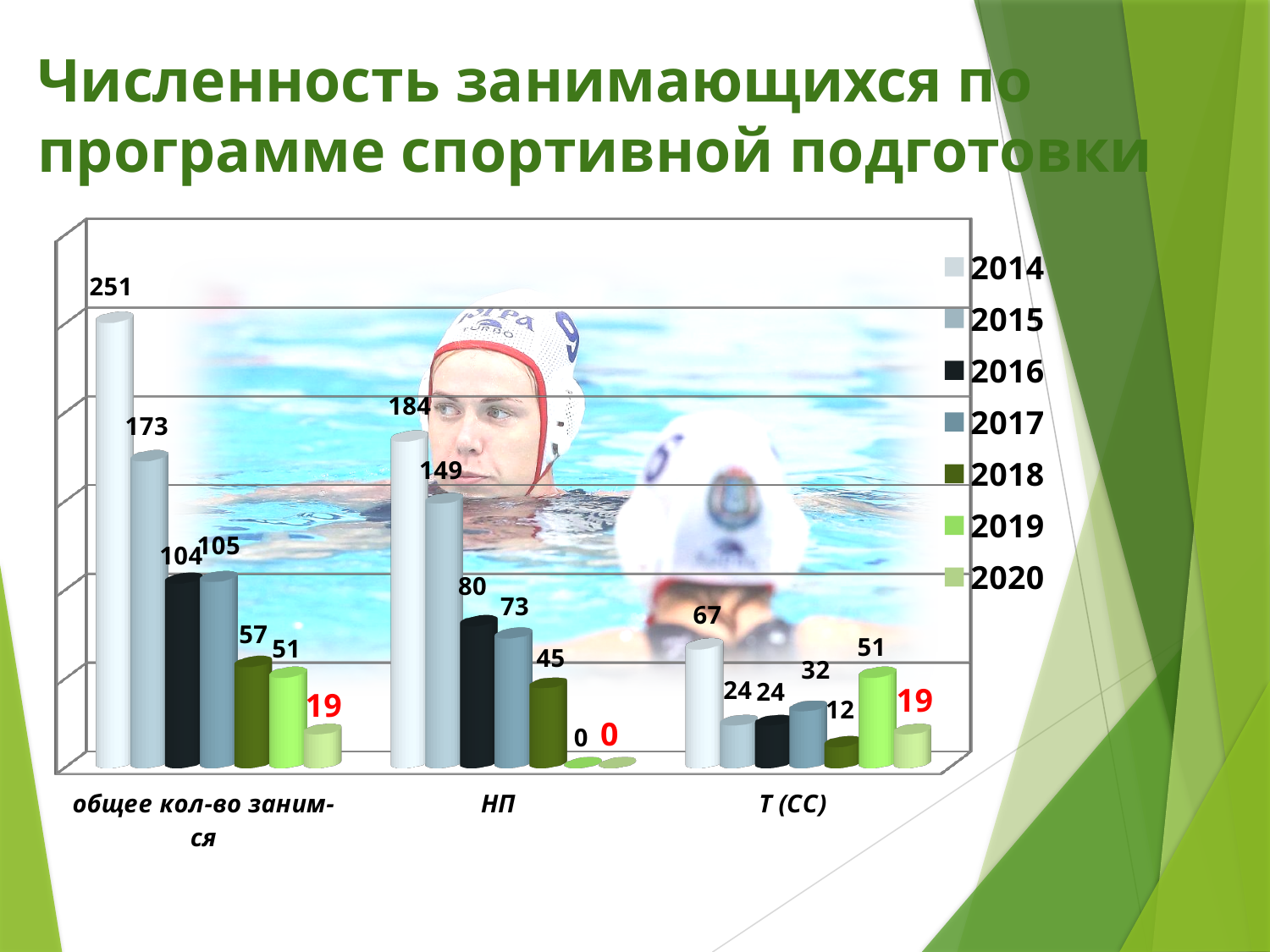
What is the value for 2020 in the "НП" category? 0 What is the value for 2015 in the "НП" category? 149 Which is larger in the "НП" category: the value for 2016 or the value for 2017? 2016 What kind of chart is shown on the slide? bar chart How many categories are shown on the x axis? 3 Which year has the highest value in the "Т (СС)" category? 2014 What is the difference between the 2014 and 2015 values in the "общее кол-во заним-ся" category? 78 What is the value for 2014 in the "общее кол-во заним-ся" category? 251 Which year is shown in the darkest (black) bars according to the legend? 2016 How many series does the legend list? 7 What is the value for 2019 in the "Т (СС)" category? 51 Which year has the lowest value in the "общее кол-во заним-ся" category? 2020